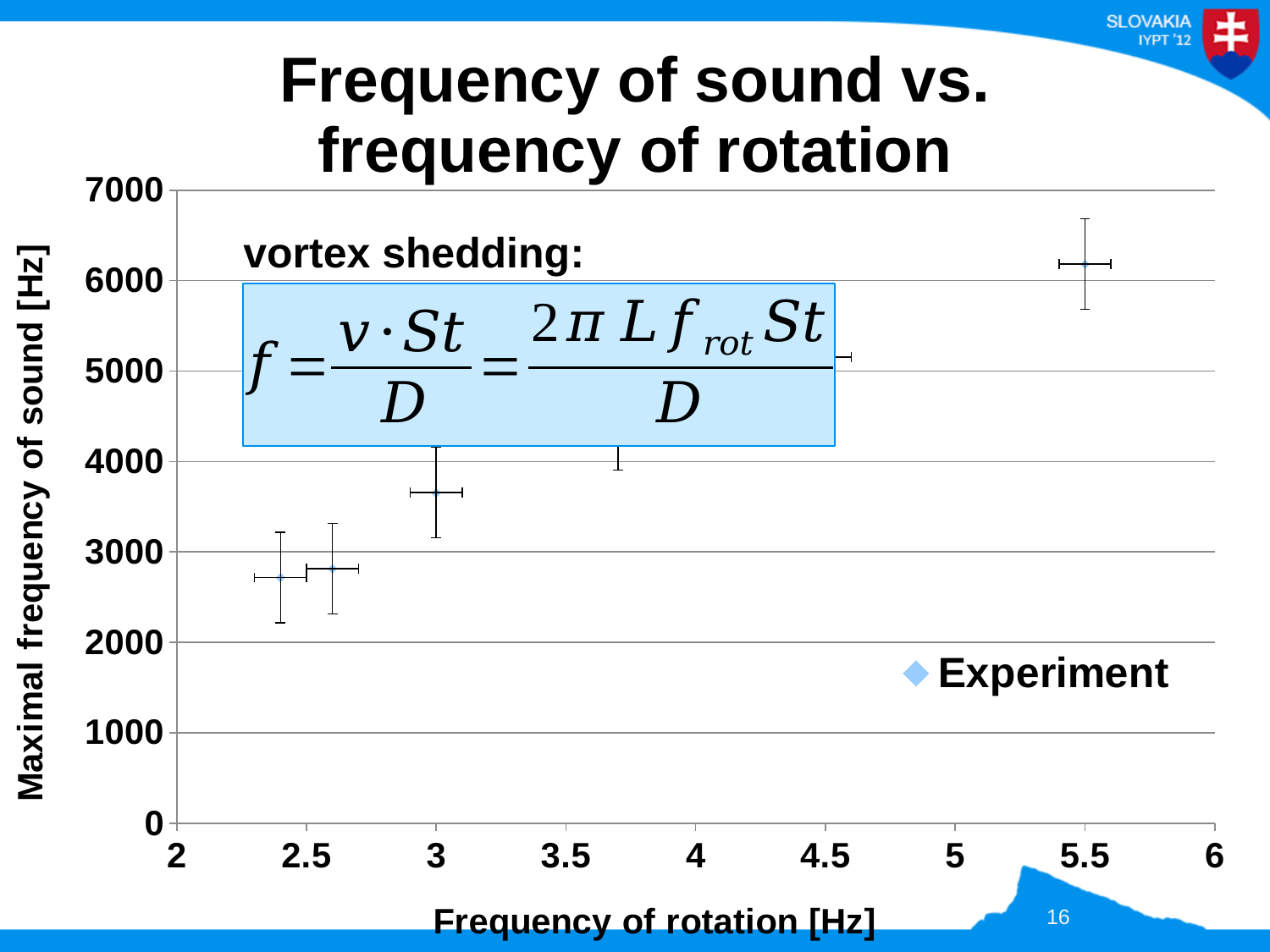
At which frequency of rotation is the maximal frequency of sound highest? 5.5 Hz How many series does the legend list? 1 What is the name of the series shown in the legend? Experiment Is the maximal frequency of sound at a rotation frequency of 3 Hz greater or less than 3000 Hz? greater Which has a higher maximal frequency of sound: the point at 3 Hz rotation or the point at 5.5 Hz rotation? 5.5 Hz What is the label of the x axis? Frequency of rotation [Hz] Do the values of maximal frequency of sound rise or fall as the frequency of rotation increases? rise Is the maximal frequency of sound at a rotation frequency of 5.5 Hz greater or less than 5000 Hz? greater What is the title of the chart? Frequency of sound vs. frequency of rotation What kind of chart is shown on the slide? scatter chart Is the maximal frequency of sound at a rotation frequency of 2.4 Hz greater or less than 3000 Hz? less